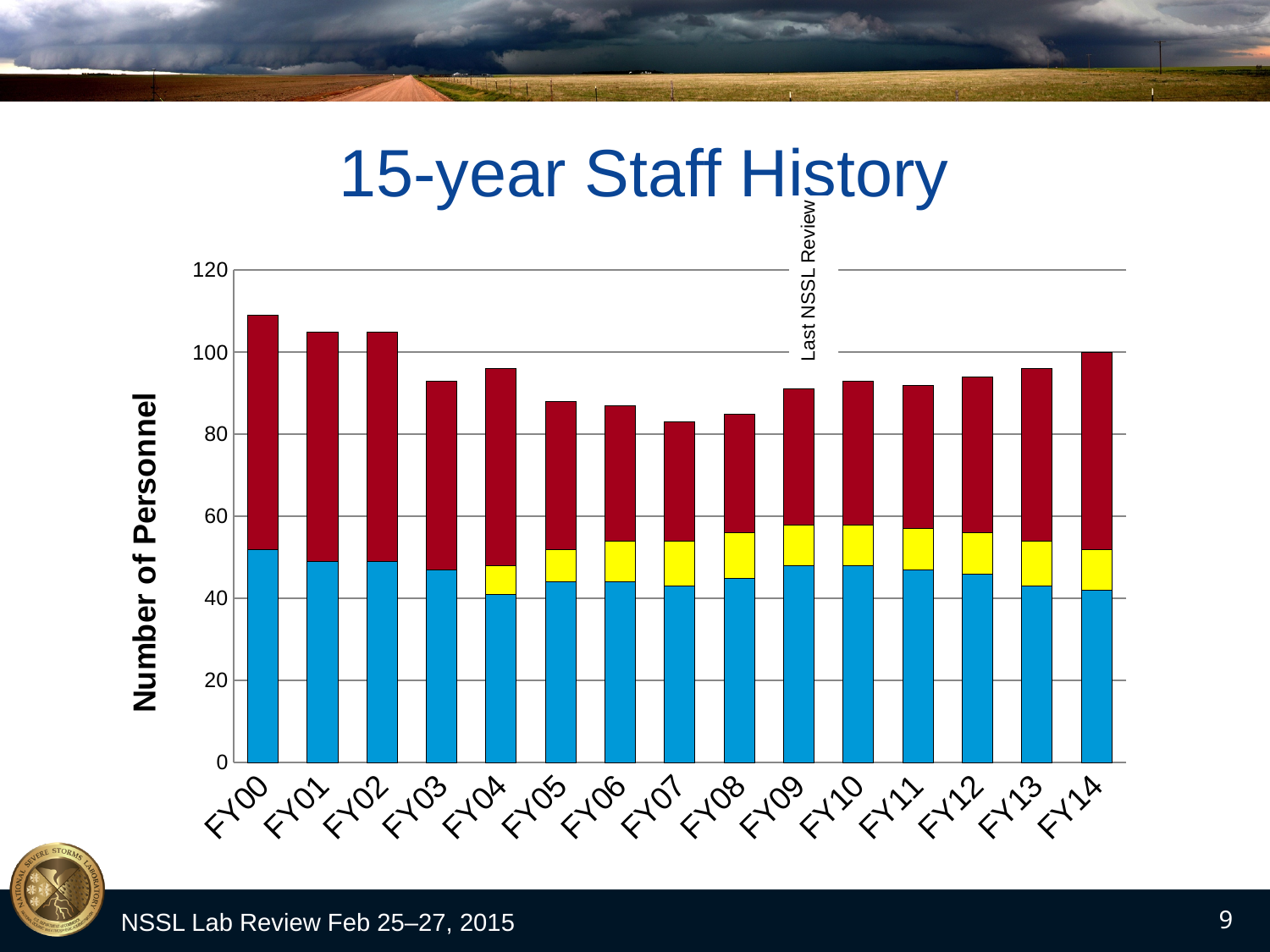
Is the blue segment for FY04 greater or less than 60? less Which fiscal year has the highest total number of personnel? FY00 How many fiscal years are shown on the x axis of the chart? 15 What kind of chart is shown on the slide? stacked bar chart Is the total number of personnel for FY03 greater or less than 100? less Does the total number of personnel rise or fall from FY00 to FY07? fall Is the total number of personnel for FY07 greater or less than 100? less Does the total number of personnel rise or fall from FY07 to FY14? rise Which has a larger total number of personnel, FY00 or FY14? FY00 What is the title of the chart? 15-year Staff History What is the label on the vertical axis of the chart? Number of Personnel